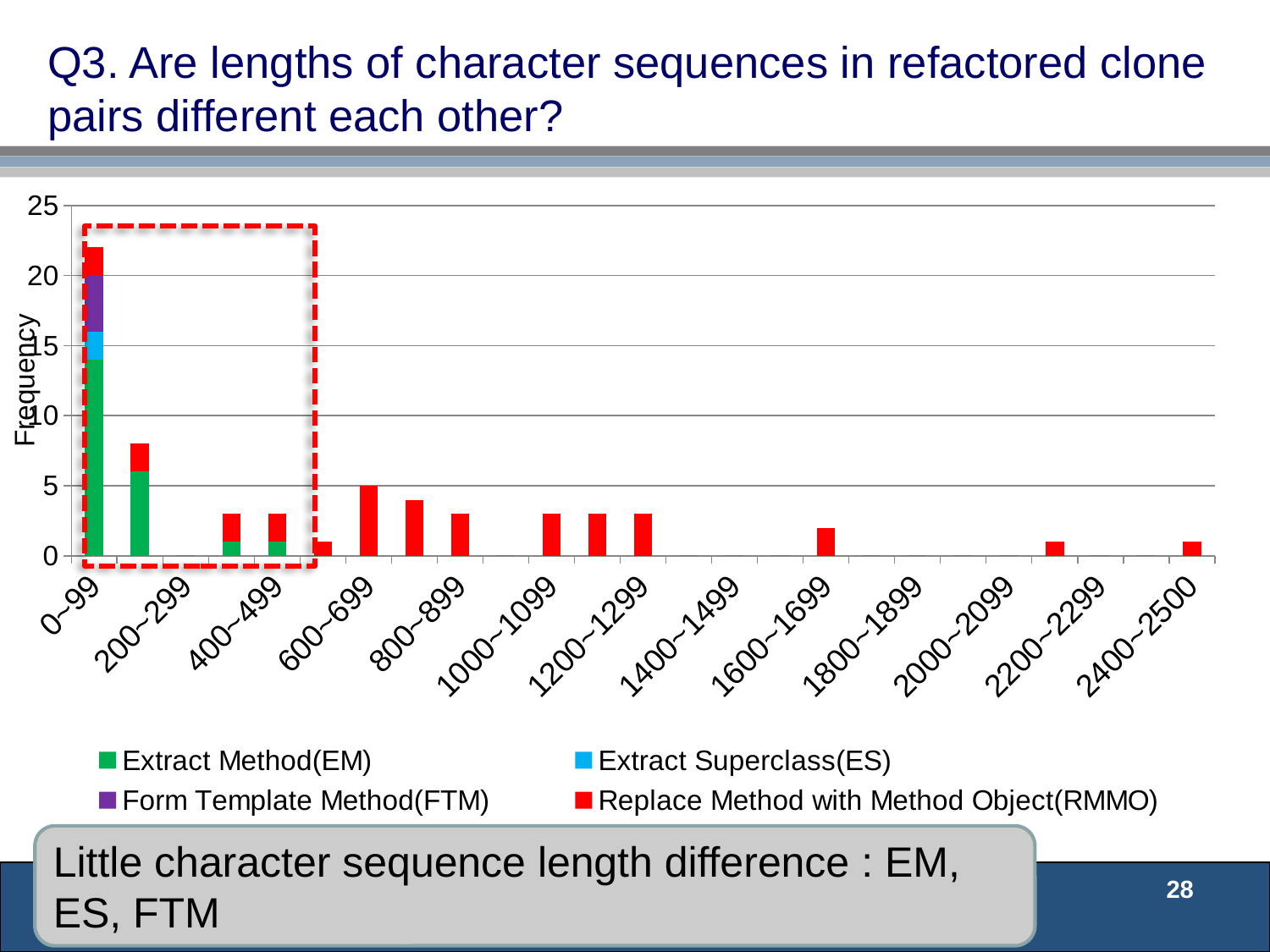
Which category has the highest total frequency? 0~99 Which has a higher total frequency, 200~299 or 600~699? 600~699 Is the total frequency for 200~299 greater or less than 5? less What kind of chart is shown on the slide? Stacked bar chart Do the frequencies generally rise or fall as the character sequence length increases along the x axis? fall Which has a higher total frequency, 0~99 or 200~299? 0~99 Is the frequency for 1600~1699 greater or less than 5? less Is the total frequency for 200~299 greater or less than 10? less How many series does the legend list? 4 What is the label of the y axis? Frequency